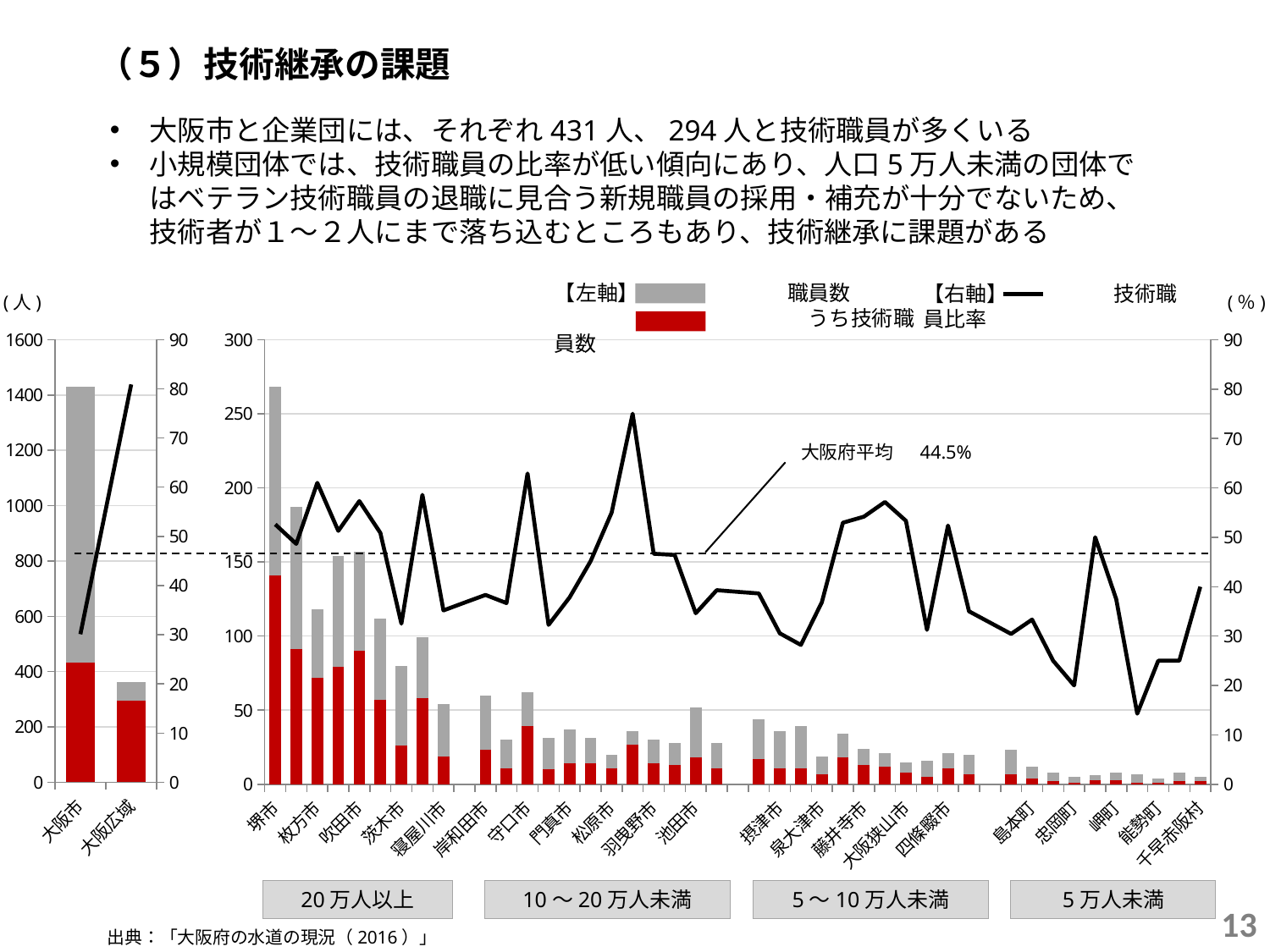
In the right chart, is the うち技術職員数 for 堺市 greater or less than 100? greater In the left chart, is the 技術職員比率 for 大阪広域 greater or less than 70? greater In the left chart, is the 職員数 for 大阪市 greater or less than 1200? greater In the right chart, which municipality has the highest 職員数? 堺市 How many series does the legend list? 3 In the right chart, what is the 大阪府平均 value shown for the dashed line? 44.5% What kind of chart is shown on the slide? bar chart with a line In the left chart, which has the larger 職員数, 大阪市 or 大阪広域? 大阪市